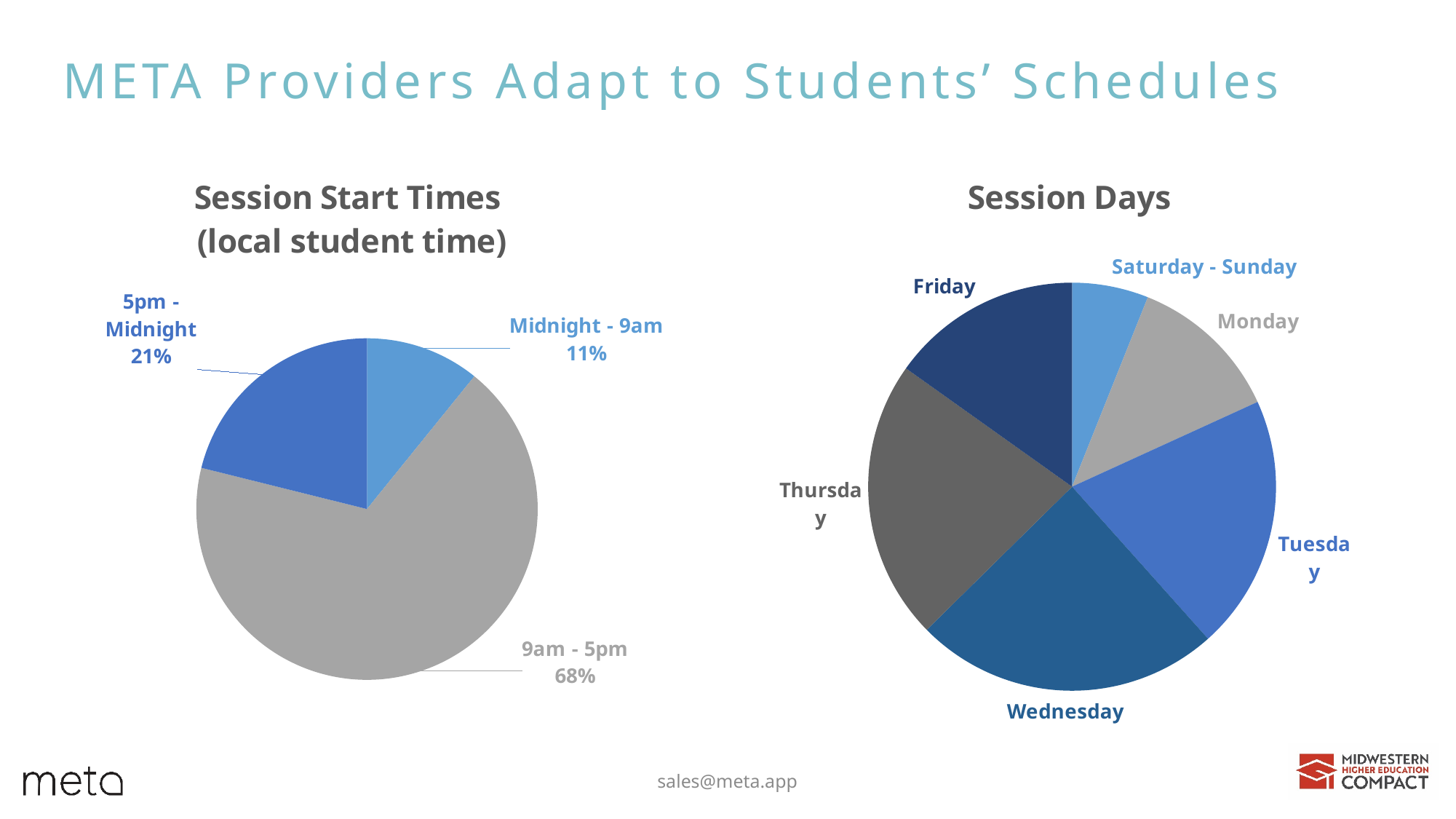
In the Session Start Times chart, which time slot has the smallest share? Midnight - 9am In the Session Start Times chart, what percentage is shown for Midnight - 9am? 11% In the Session Days chart, which slice is larger: Monday or Saturday - Sunday? Monday How many categories are shown in the Session Days chart? 6 In the Session Start Times chart, what percentage is shown for 5pm - Midnight? 21% In the Session Start Times chart, what share of sessions start between 9am and 5pm? 68% How many slices does the Session Start Times chart have? 3 In the Session Start Times chart, which time slot has the largest share? 9am - 5pm In the Session Start Times chart, which is larger: 5pm - Midnight or Midnight - 9am? 5pm - Midnight What type of chart is the Session Days chart? Pie chart In the Session Start Times chart, what is the difference in percentage points between 9am - 5pm and 5pm - Midnight? 47 In the Session Days chart, which day category has the smallest slice? Saturday - Sunday